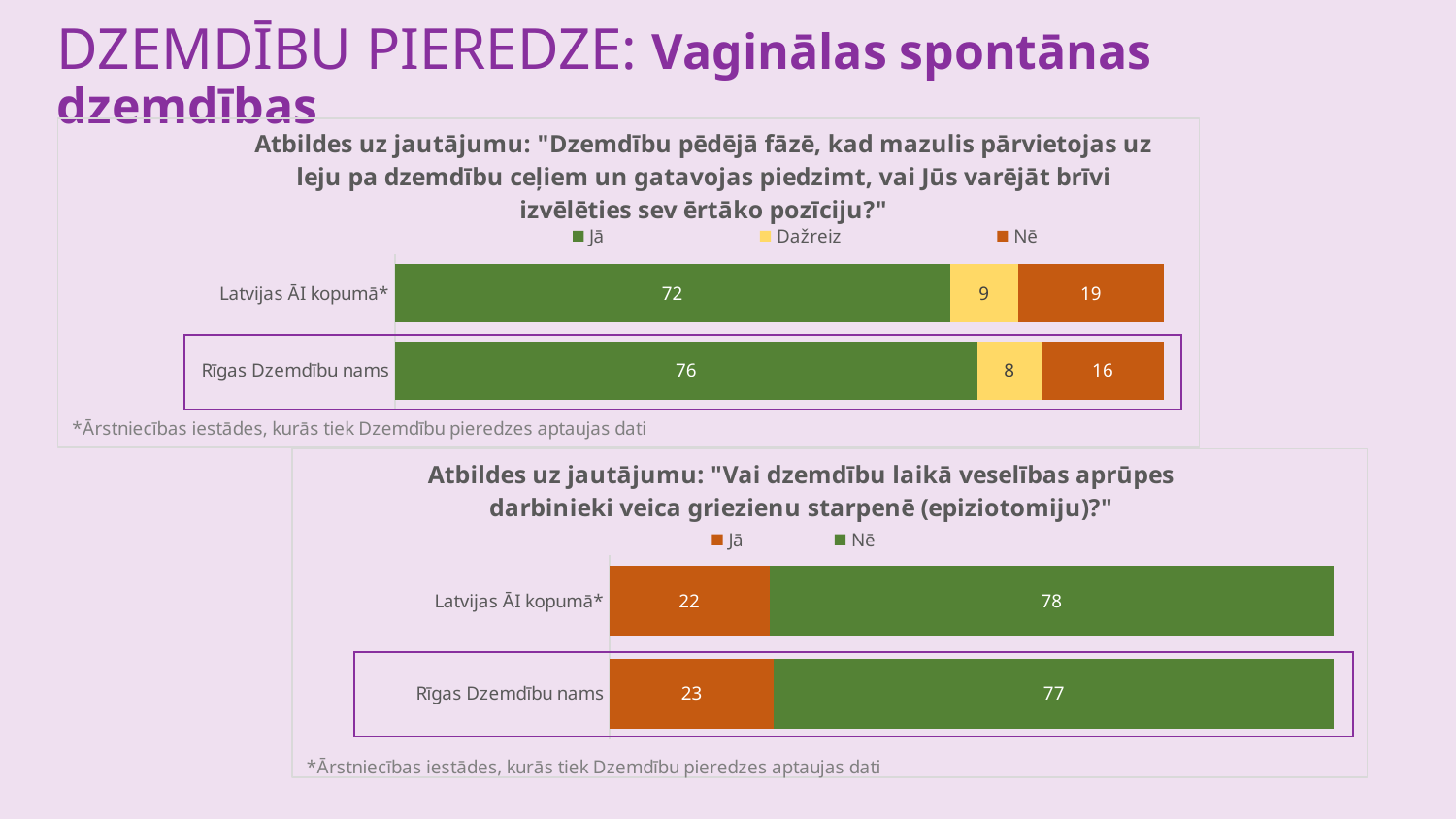
In the top chart, which category has the higher "Nē" value? Latvijas ĀI kopumā* In the bottom chart, what is the "Nē" value for Rīgas Dzemdību nams? 77 In the top chart (about choosing a comfortable position), what is the "Jā" value for Rīgas Dzemdību nams? 76 In the top chart, what is the total of the stacked bar for Latvijas ĀI kopumā*? 100 In the bottom chart, how many categories are shown? 2 In the bottom chart (about episiotomy), what is the "Jā" value for Latvijas ĀI kopumā*? 22 In the top chart, what is the "Nē" value for Latvijas ĀI kopumā*? 19 In the top chart, how many series does the legend list? 3 In the bottom chart, which colour represents "Nē"? Green In the top chart, what is the difference between the "Jā" values for Rīgas Dzemdību nams and Latvijas ĀI kopumā*? 4 In the top chart, what is the "Dažreiz" value for Rīgas Dzemdību nams? 8 What kind of chart is the bottom chart? Stacked bar chart